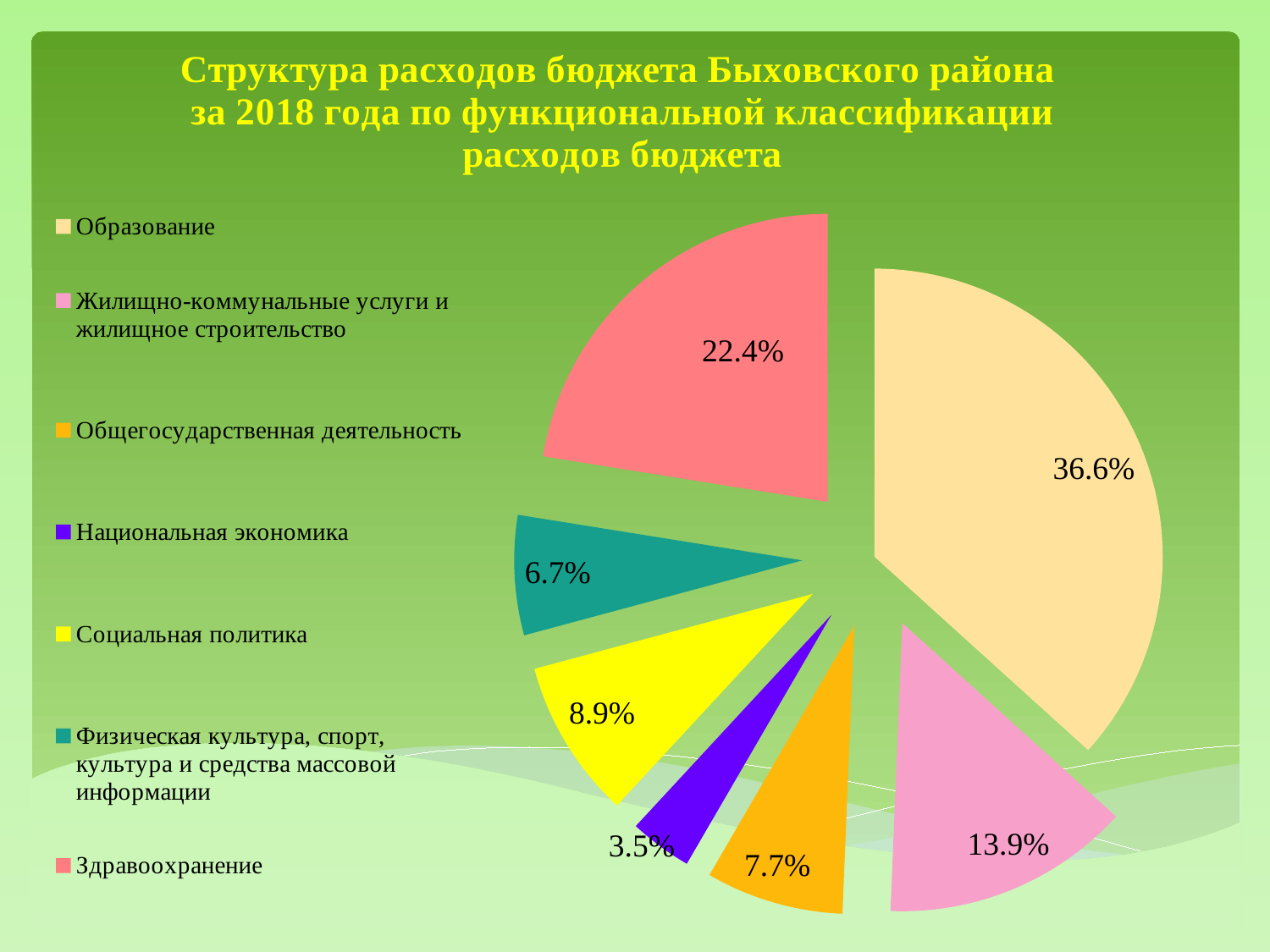
What kind of chart is shown on the slide? pie chart What is the difference in percentage points between the share for Образование and the share for Здравоохранение? 14.2 How many categories does the pie chart show? 7 What share of budget expenditure goes to Образование? 36.6% Which is larger: the share for Общегосударственная деятельность or the share for Физическая культура, спорт, культура и средства массовой информации? Общегосударственная деятельность Which category has the smallest share of budget expenditure? Национальная экономика What colour is the slice for Социальная политика? yellow What share of budget expenditure goes to Социальная политика? 8.9% What share of budget expenditure goes to Жилищно-коммунальные услуги и жилищное строительство? 13.9% What share of budget expenditure goes to Национальная экономика? 3.5% Which category has the largest share of budget expenditure? Образование What share of budget expenditure goes to Здравоохранение? 22.4%